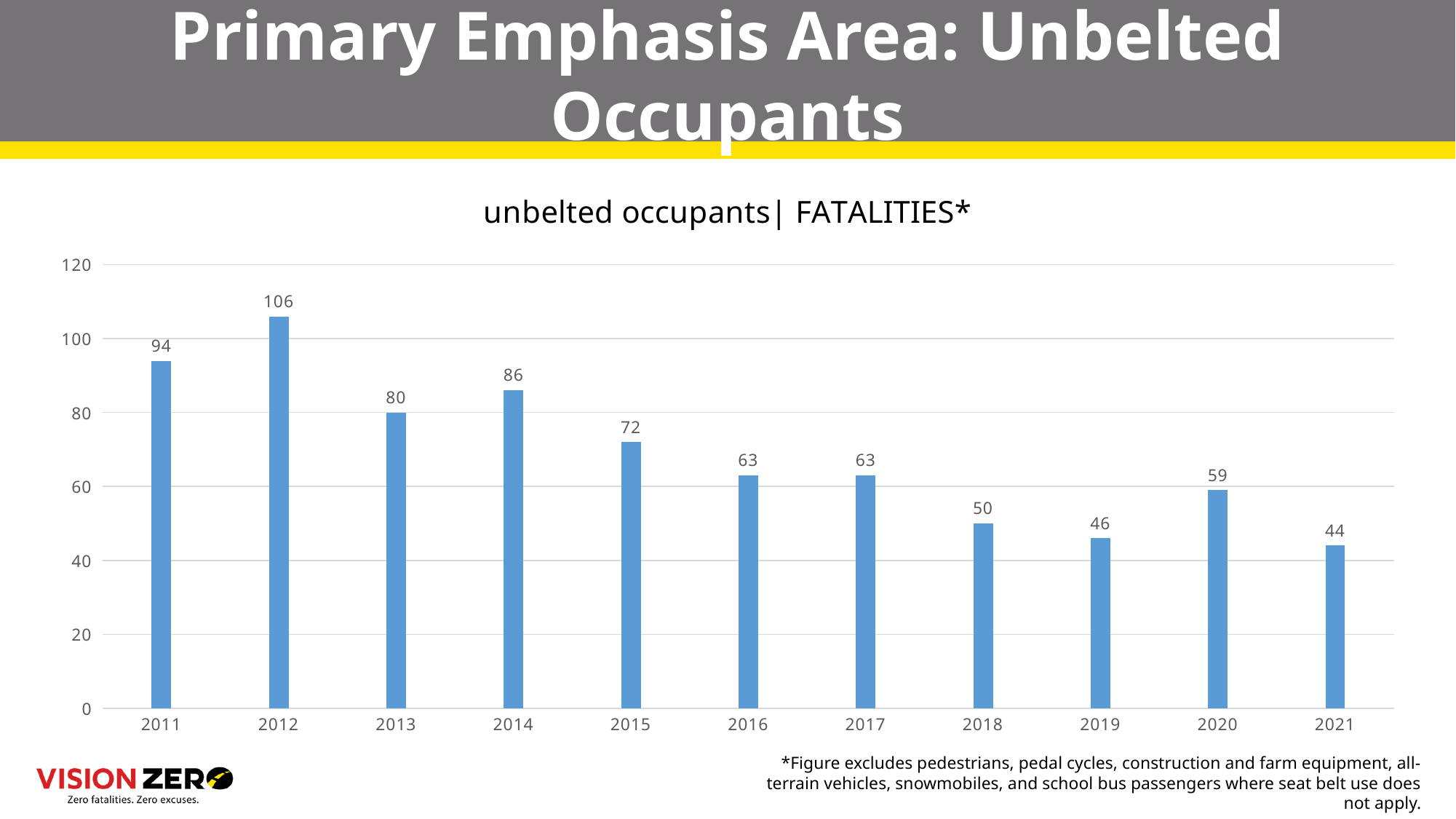
What is the difference between the values for 2012 and 2021? 62 What is the title of the chart? unbelted occupants| FATALITIES* How many years are shown on the x axis? 11 Which year has the lowest value? 2021 What kind of chart is shown? bar chart Do the values generally rise or fall from 2012 to 2021? fall Which year has the highest value? 2012 Is the value for 2011 greater or less than 80? greater What is the value for 2018? 50 What is the value for 2012? 106 What is the value for 2021? 44 Which is larger, the value for 2014 or the value for 2015? 2014